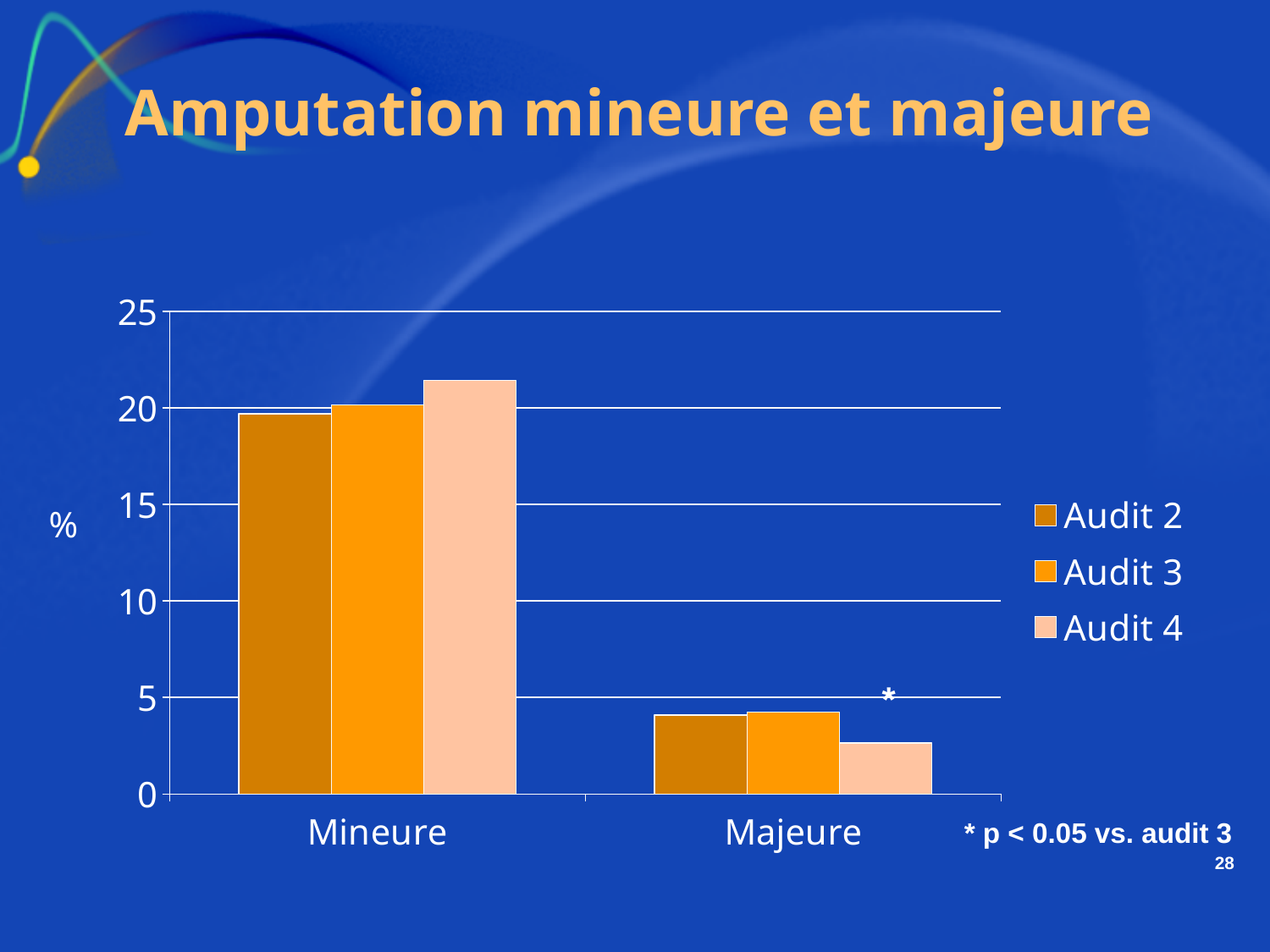
Is the value for Audit 2 in the Majeure category greater or less than 5? less Which category has the higher values, Mineure or Majeure? Mineure Is the value for Audit 4 in the Mineure category greater or less than 20? greater What is the title of the slide? Amputation mineure et majeure In the Majeure category, is the bar for Audit 2 or Audit 4 larger? Audit 2 In the Mineure category, which audit has the highest bar? Audit 4 What kind of chart is shown on the slide? bar chart How many series does the legend list? 3 In the Majeure category, which audit has the lowest bar? Audit 4 Is the value for Audit 4 in the Majeure category greater or less than 5? less How many categories are shown on the x axis? 2